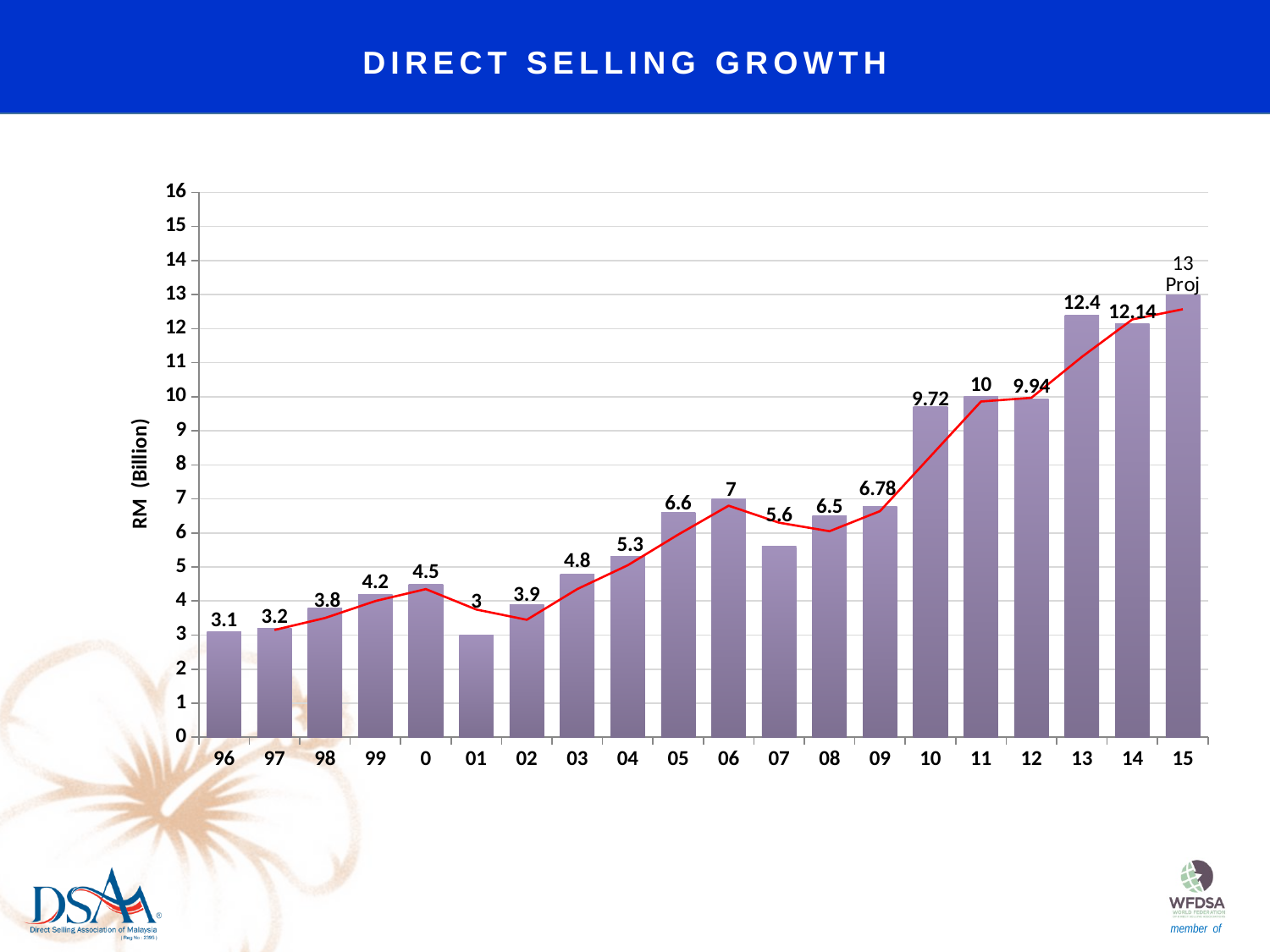
How many years are shown on the x axis? 20 What is the value for 96? 3.1 What is the value for 10? 9.72 Which year has the highest value? 15 What is the difference between the values for 06 and 07? 1.4 Which year has the lowest value? 01 What is the value for 09? 6.78 What kind of chart is this? Bar chart with a line overlay What is the difference between the values for 13 and 14? 0.26 What is the title of the chart? DIRECT SELLING GROWTH Which is larger, the value for 11 or the value for 08? 11 What is the value for 14? 12.14